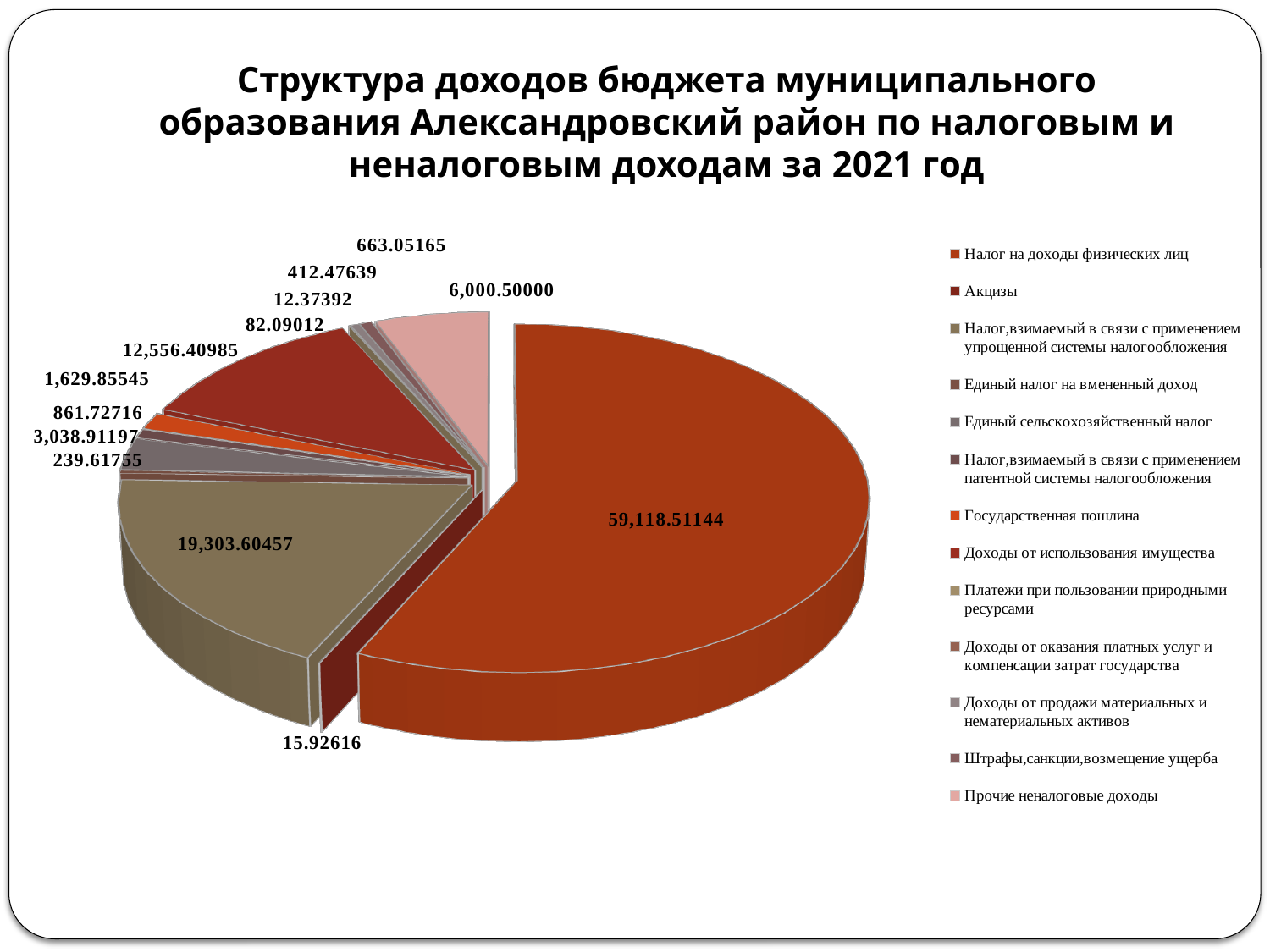
What year does the chart title say the data is for? 2021 What type of chart is shown on the slide? Pie chart What is the value shown for Налог на доходы физических лиц? 59,118.51144 What is the smallest value labelled on the pie chart? 12.37392 What is the value shown for Налог, взимаемый в связи с применением упрощенной системы налогообложения? 19,303.60457 What is the difference between the values for Налог на доходы физических лиц and Налог, взимаемый в связи с применением упрощенной системы налогообложения? 39,814.90687 What is the value shown for Доходы от использования имущества? 12,556.40985 Which category has the largest slice of the pie? Налог на доходы физических лиц What is the value shown for Прочие неналоговые доходы? 6,000.50000 How many categories does the legend of the pie chart list? 13 What is the value shown for Единый сельскохозяйственный налог? 3,038.91197 Which is larger: Прочие неналоговые доходы or Единый сельскохозяйственный налог? Прочие неналоговые доходы